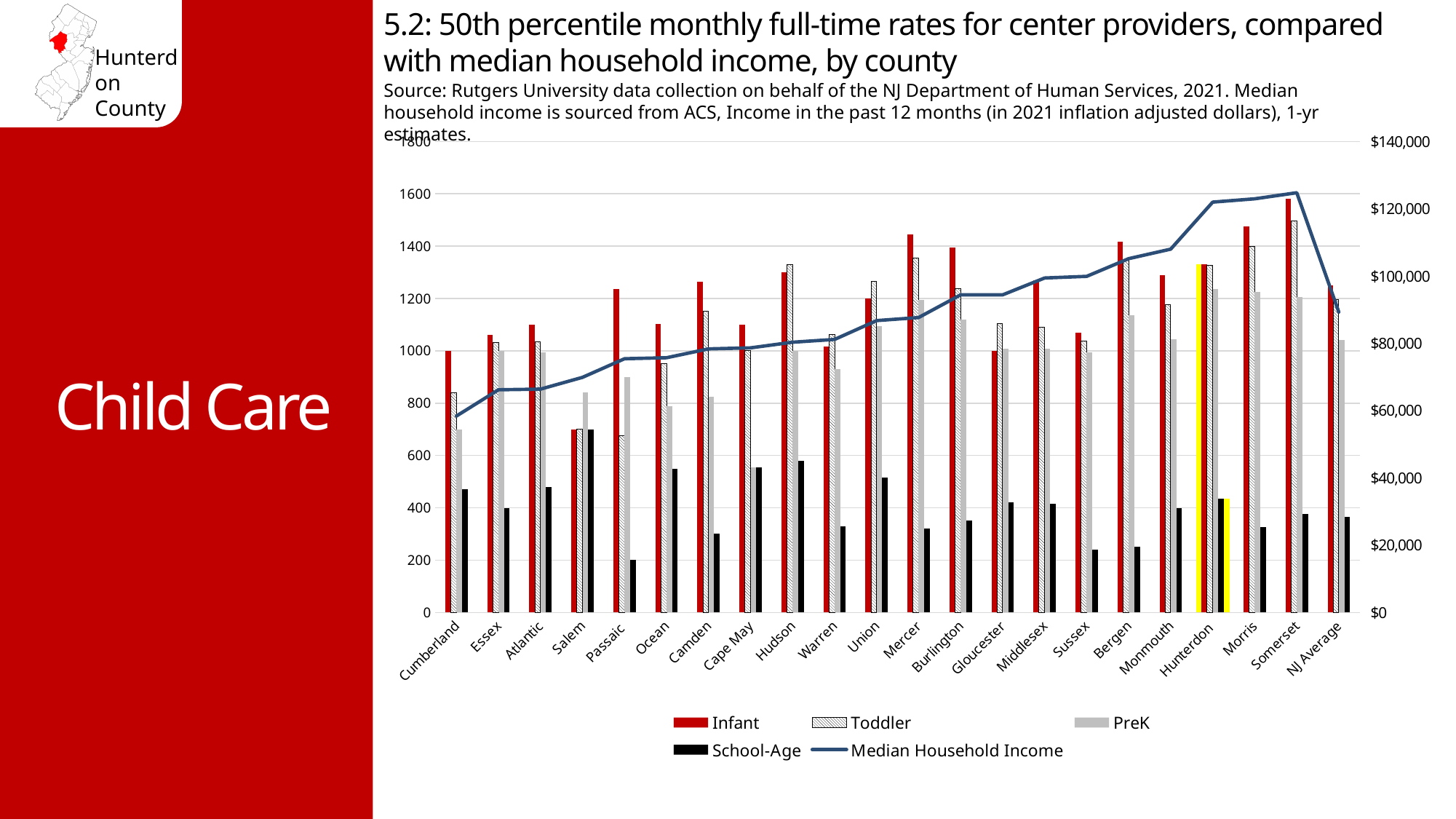
Which county's bars are highlighted in yellow? Hunterdon Which county has the lowest School-Age rate? Passaic Which is larger, the Infant rate for Somerset or the Infant rate for Cumberland? Somerset Which county has the highest School-Age rate? Salem Is the Infant rate for Somerset greater or less than 1400? greater Which county has the lowest Infant rate? Salem Is the Median Household Income for Hunterdon greater or less than $100,000? greater Which county has the highest Infant rate? Somerset Which county has the highest Median Household Income? Somerset How many series does the legend list? 5 What kind of chart is shown on the slide? A bar chart combined with a line How many categories are shown along the x axis? 22